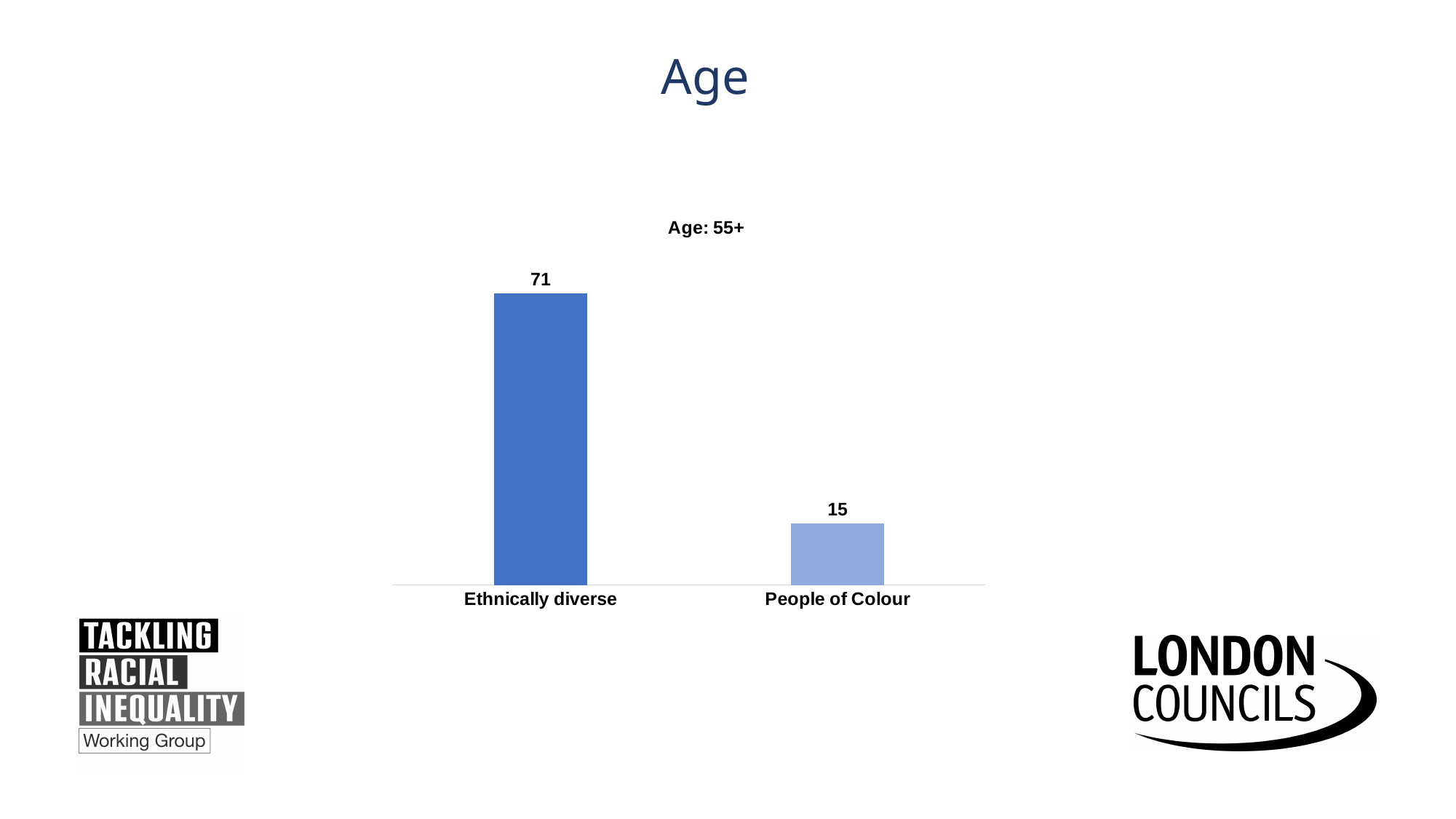
What is the title of the chart? Age: 55+ Which bar is a lighter shade of blue? People of Colour Which category has the highest value? Ethnically diverse Which category has the lowest value? People of Colour What kind of chart is shown on the slide? Bar chart How many categories are shown in the chart? 2 What is the difference between the values for Ethnically diverse and People of Colour? 56 What is the value for People of Colour? 15 Which is larger, the value for Ethnically diverse or the value for People of Colour? Ethnically diverse What is the value for Ethnically diverse? 71